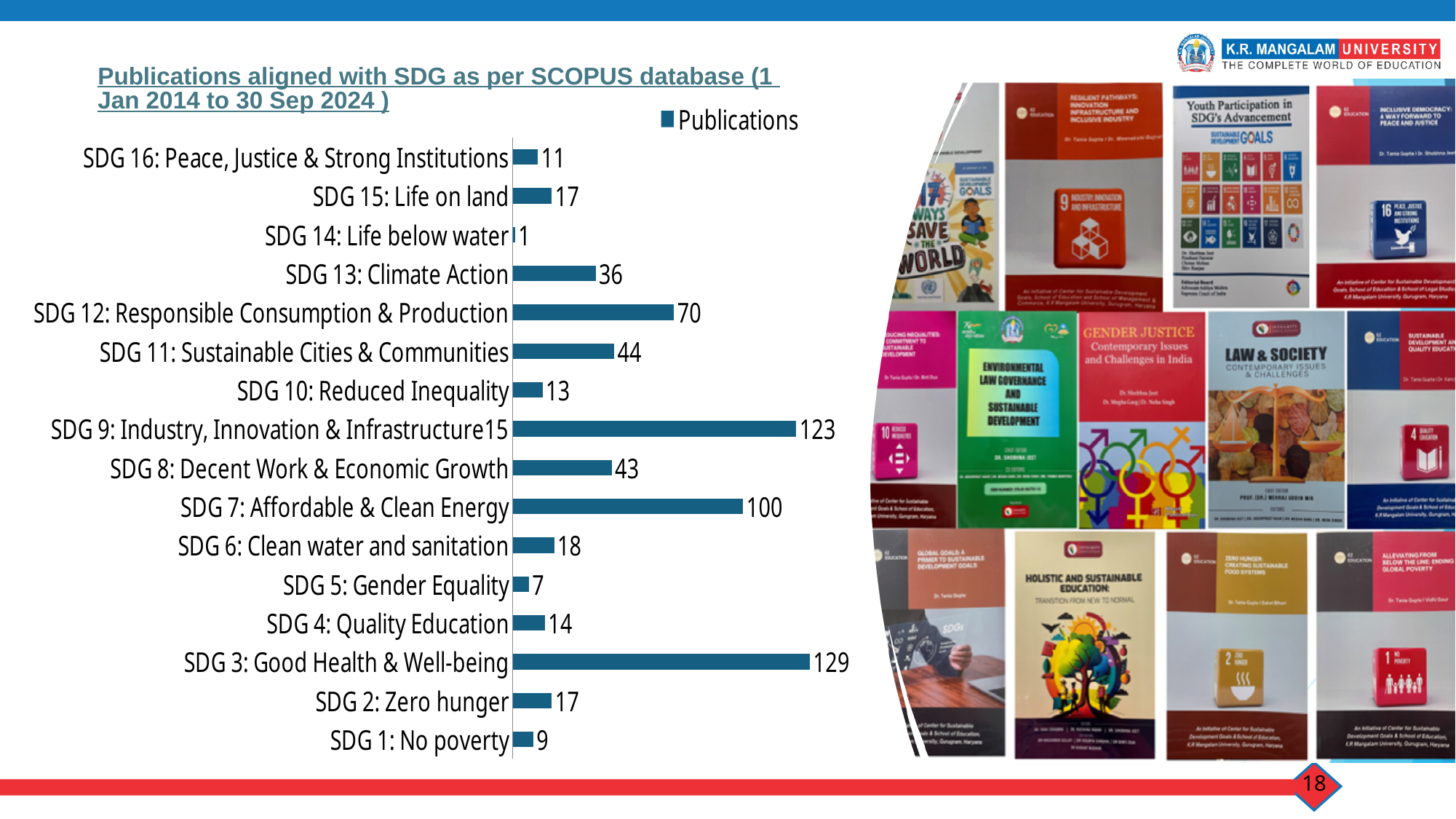
What is the legend entry shown for the chart? Publications What is the value for SDG 12: Responsible Consumption & Production? 70 How many series does the legend list? 1 Which SDG category has the lowest number of publications? SDG 14: Life below water How many SDG categories are plotted in the chart? 16 What is the value for SDG 13: Climate Action? 36 What kind of chart is shown on the slide? Bar chart How many publications are shown for SDG 7: Affordable & Clean Energy? 100 Which has more publications, SDG 8: Decent Work & Economic Growth or SDG 6: Clean water and sanitation? SDG 8: Decent Work & Economic Growth What is the difference between the publications for SDG 3: Good Health & Well-being and SDG 9: Industry, Innovation & Infrastructure? 6 Which SDG category has the highest number of publications? SDG 3: Good Health & Well-being What is the difference between the values for SDG 12: Responsible Consumption & Production and SDG 11: Sustainable Cities & Communities? 26